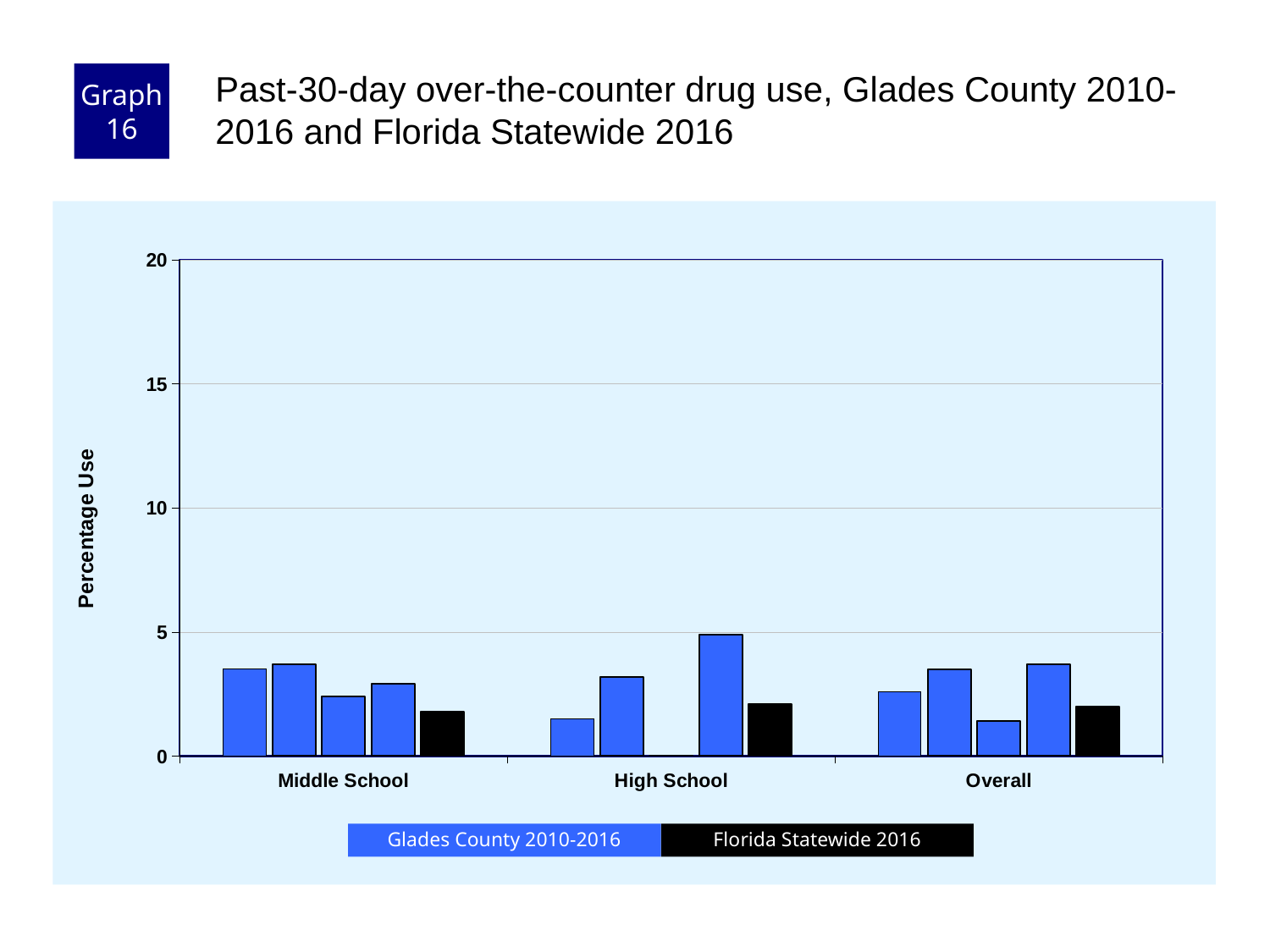
Is any bar on the chart greater than 10? no What is the highest value shown on the y axis? 20 How many series does the legend list? 2 How many categories are shown on the x axis? 3 Which category contains the tallest bar on the chart? High School Is the Florida Statewide 2016 value for Middle School greater or less than 5? less Which colour represents Florida Statewide 2016 in the legend? black What is the label of the y axis? Percentage Use Is the tallest Glades County 2010-2016 bar for High School greater or less than 10? less What kind of chart is shown on the slide? bar chart